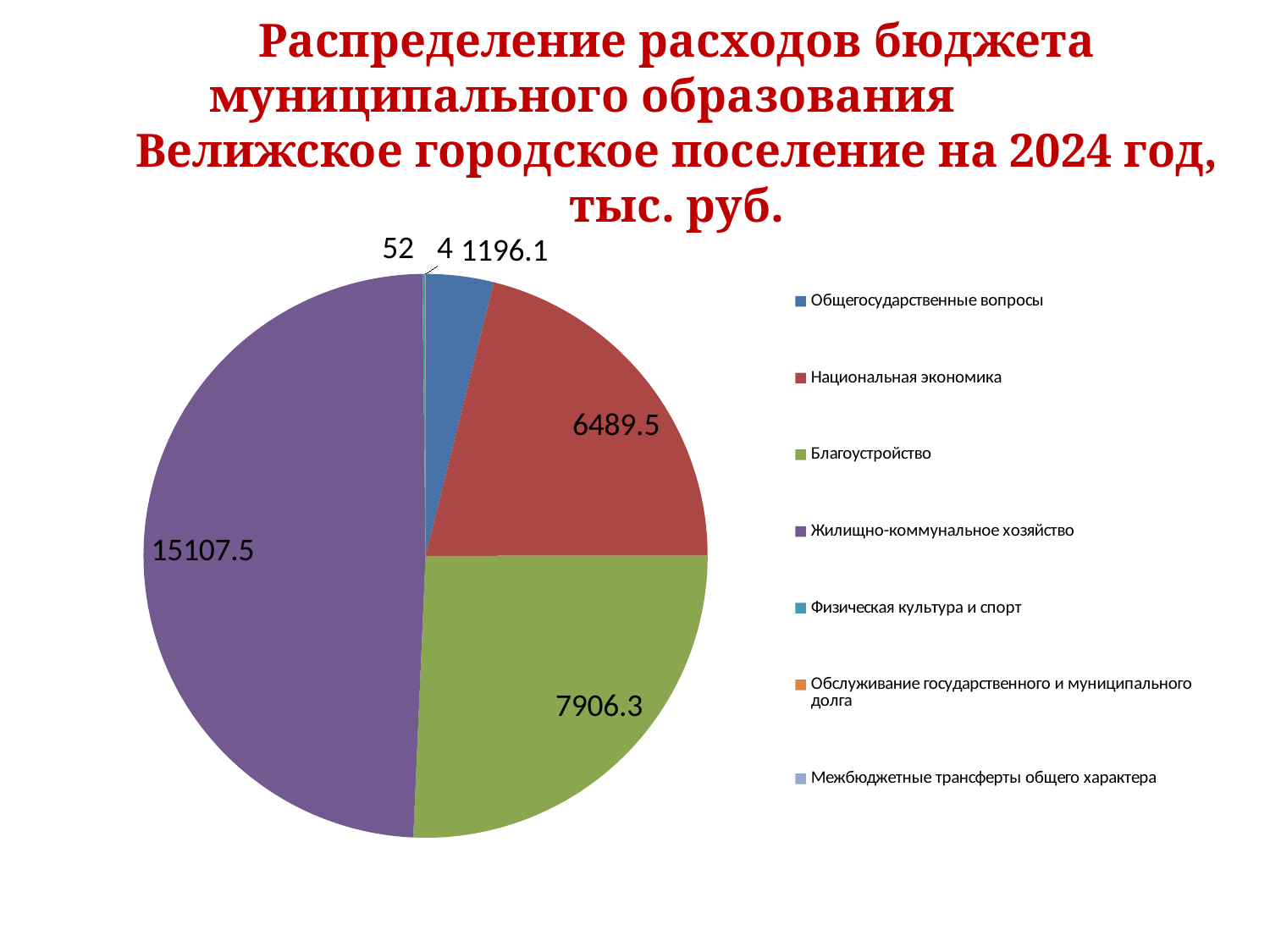
What is the value for Национальная экономика? 6489.5 What is the value for Общегосударственные вопросы? 1196.1 What is the difference between Благоустройство and Национальная экономика? 1416.8 Which is larger, Благоустройство or Национальная экономика? Благоустройство What unit of measurement is stated in the chart title? тыс. руб. What is the difference between Национальная экономика and Общегосударственные вопросы? 5293.4 Which category has the largest slice of the pie? Жилищно-коммунальное хозяйство What type of chart is shown on the slide? pie chart What is the value for Жилищно-коммунальное хозяйство? 15107.5 What is the difference between Жилищно-коммунальное хозяйство and Благоустройство? 7201.2 What is the value for Благоустройство? 7906.3 How many categories does the legend of the pie chart list? 7